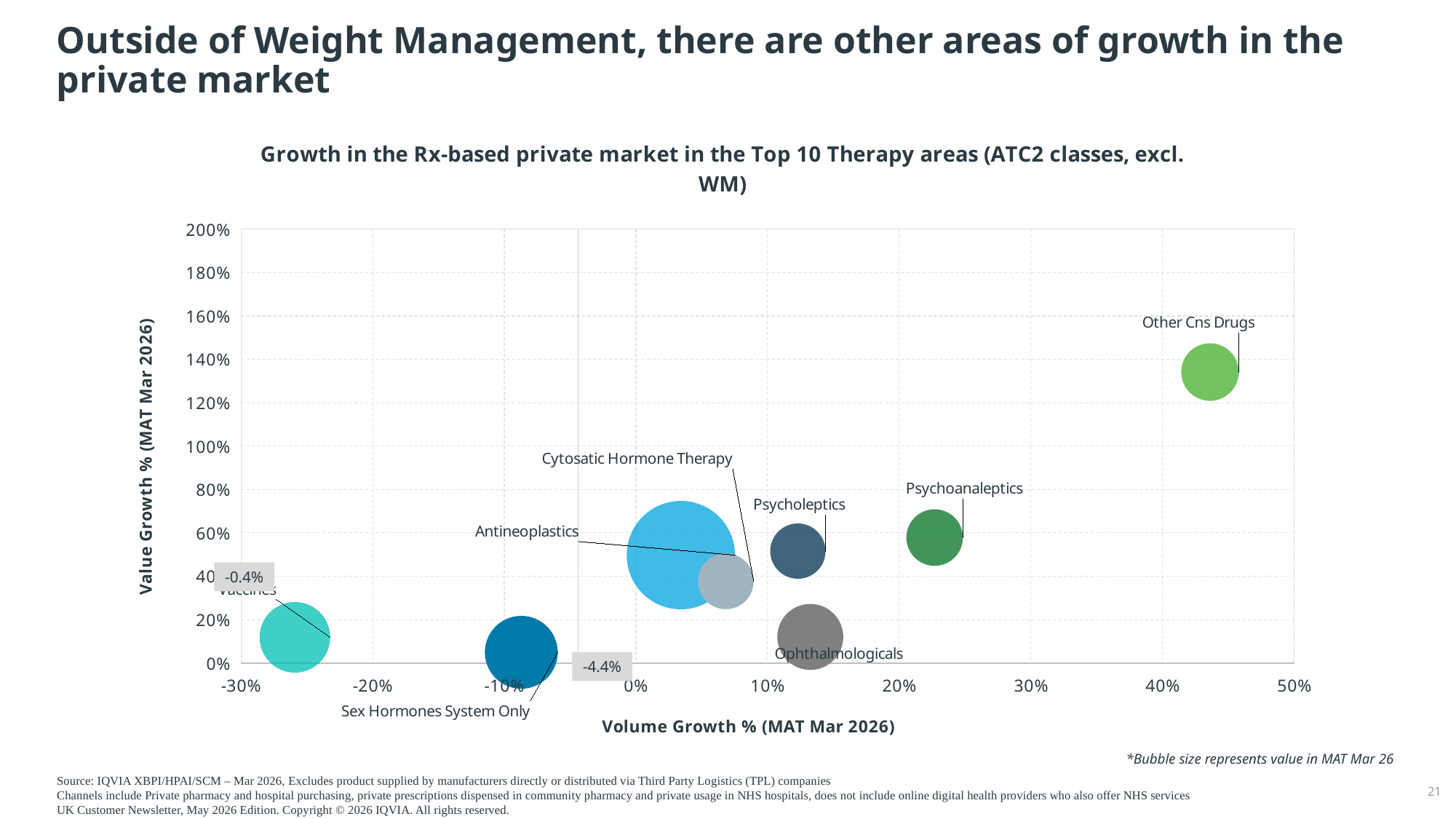
Is the volume growth % for Vaccines greater or less than -20%? less Which has the higher value growth %, Ophthalmologicals or Psycholeptics? Psycholeptics Which has the higher volume growth %, Psychoanaleptics or Psycholeptics? Psychoanaleptics Which therapy area has the largest bubble on the chart? Antineoplastics Which therapy area has the highest volume growth %? Other Cns Drugs Is the value growth % for Other Cns Drugs greater or less than 120%? greater Is the volume growth % for Psychoanaleptics greater or less than 20%? greater How many labelled therapy-area bubbles are plotted on the chart? 8 Which therapy area has the highest value growth %? Other Cns Drugs Which therapy area has the lowest volume growth %? Vaccines What is the title of the horizontal axis? Volume Growth % (MAT Mar 2026) What kind of chart is shown on the slide? bubble chart